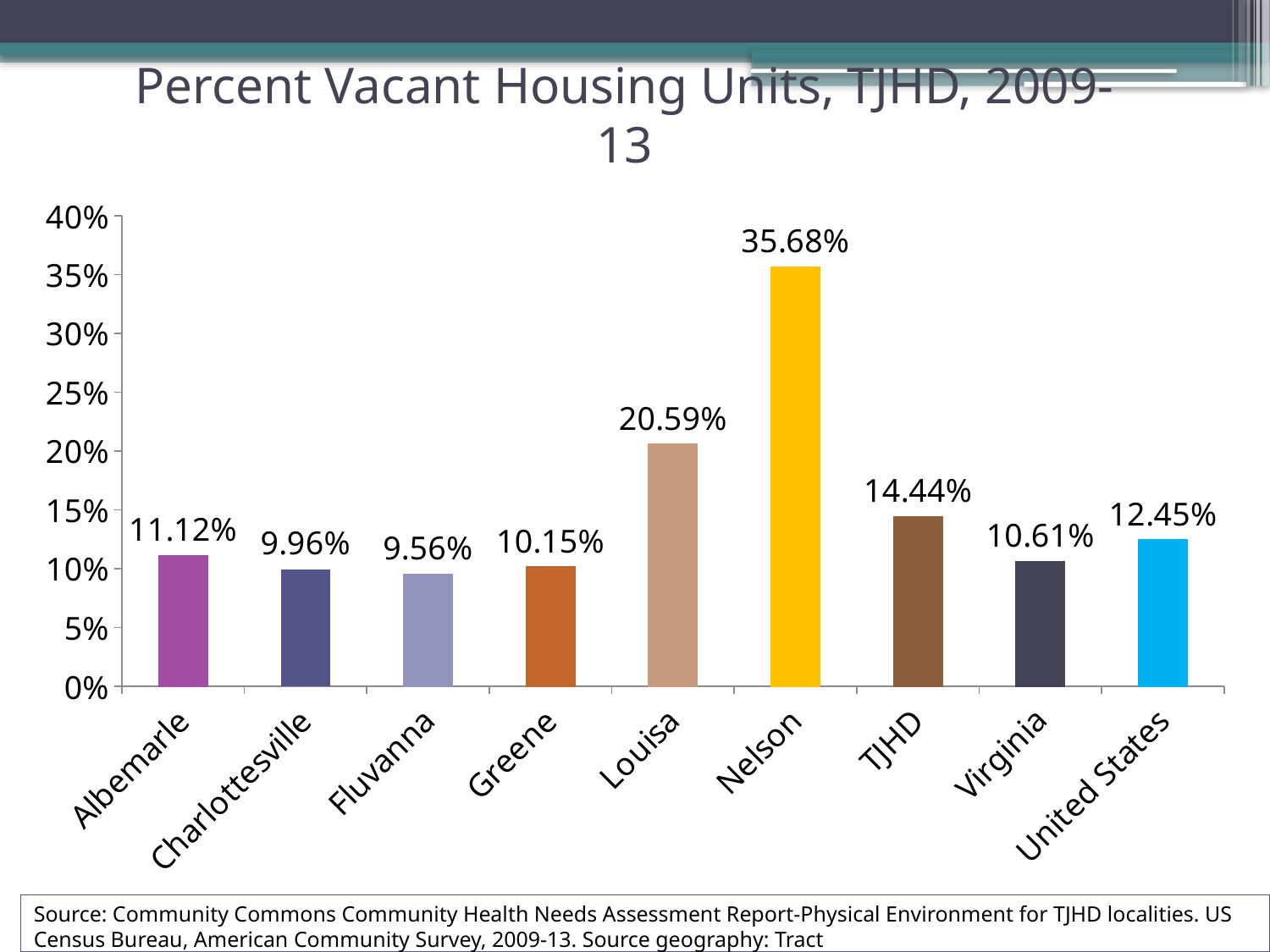
Is the value for Virginia greater or less than 15%? less How many categories are shown on the x axis? 9 Which has a higher percent of vacant housing units, Louisa or TJHD? Louisa Which locality has the highest percent of vacant housing units? Nelson What is the difference between the percent of vacant housing units for the United States and Virginia? 1.84% What is the percent of vacant housing units for the United States? 12.45% What kind of chart is shown on the slide? bar chart Which category has the lowest percent of vacant housing units? Fluvanna What is the difference between the percent of vacant housing units for Nelson and Louisa? 15.09% What is the title of the chart? Percent Vacant Housing Units, TJHD, 2009-13 What is the percent of vacant housing units for TJHD? 14.44% What is the percent of vacant housing units for Nelson? 35.68%